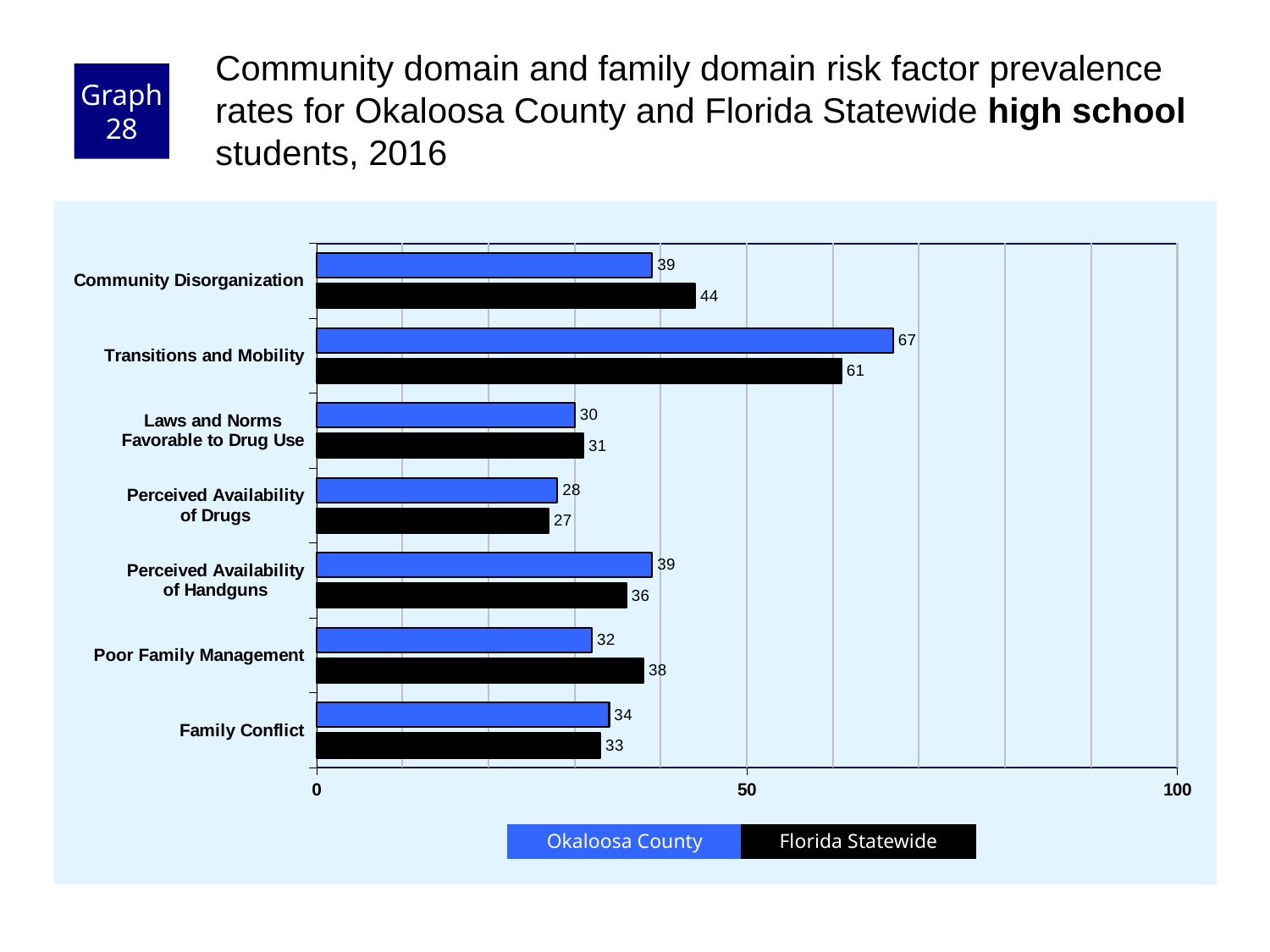
Which risk factor has the highest Okaloosa County value? Transitions and Mobility Is the Florida Statewide value for Transitions and Mobility greater or less than 50? greater How many series does the legend list? 2 What is the Florida Statewide value for Community Disorganization? 44 What is the Okaloosa County value for Transitions and Mobility? 67 What is the difference between the Okaloosa County and Florida Statewide values for Transitions and Mobility? 6 How many risk factors are shown on the chart? 7 For Poor Family Management, which is larger: the Okaloosa County value or the Florida Statewide value? Florida Statewide What is the Florida Statewide value for Poor Family Management? 38 What kind of chart is shown on the slide? bar chart Which colour represents Florida Statewide in the chart? black Which risk factor has the lowest Florida Statewide value? Perceived Availability of Drugs